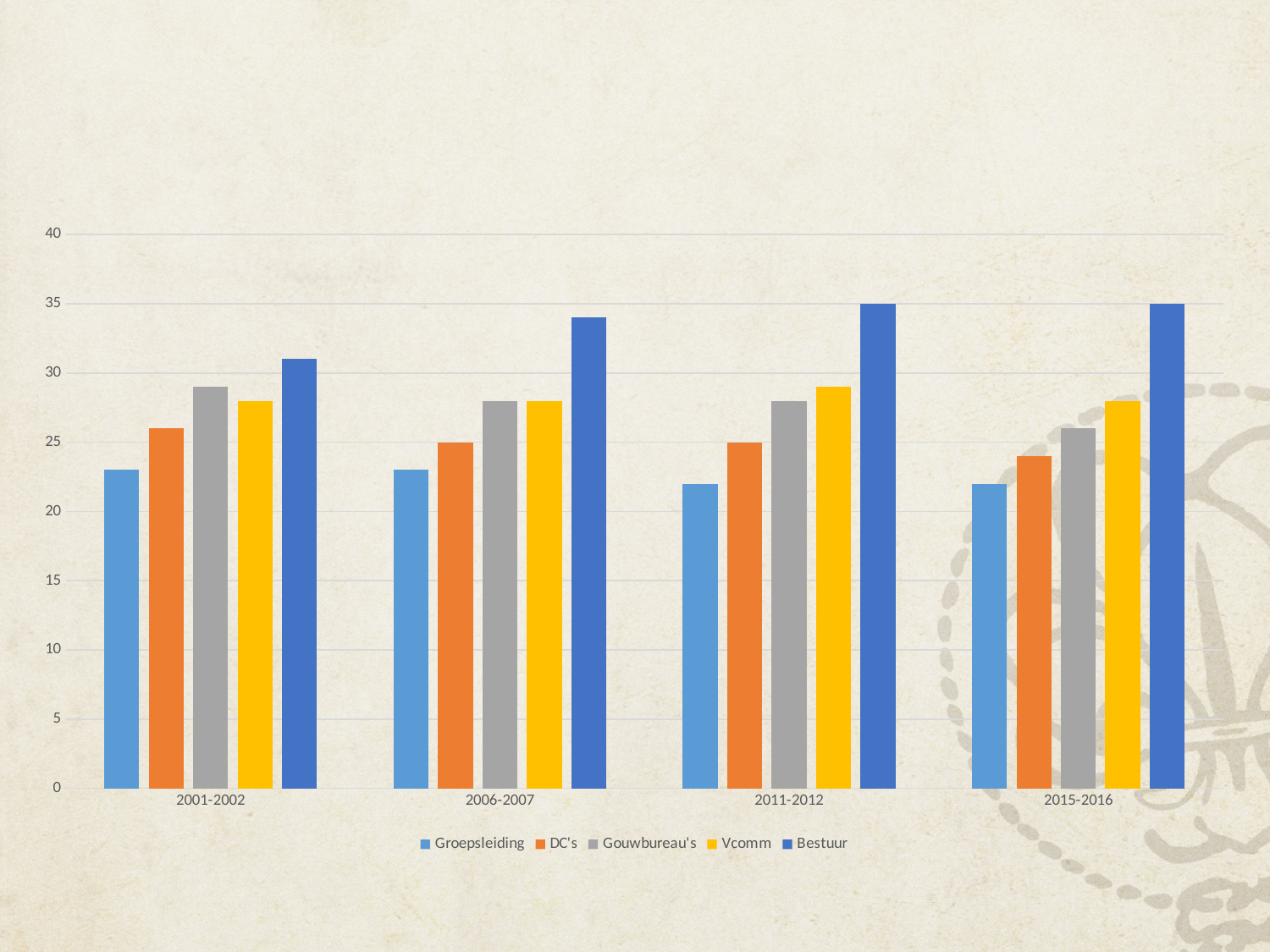
Which is larger: the Bestuur bar for 2001-2002 or the Bestuur bar for 2011-2012? 2011-2012 What is the value for Bestuur in 2011-2012? 35 Which series has the highest bar in the 2001-2002 group? Bestuur Is the value for Groepsleiding in 2001-2002 greater or less than 25? less What kind of chart is shown on the slide? bar chart Is the value for Bestuur in 2001-2002 greater or less than 30? greater How many periods are shown on the x axis? 4 Which series has the lowest bar in the 2011-2012 group? Groepsleiding What is the value for DC's in 2006-2007? 25 How many series does the legend list? 5 Does the Bestuur series generally rise or fall from 2001-2002 to 2015-2016? rise Is the value for Vcomm in 2011-2012 greater or less than 30? less